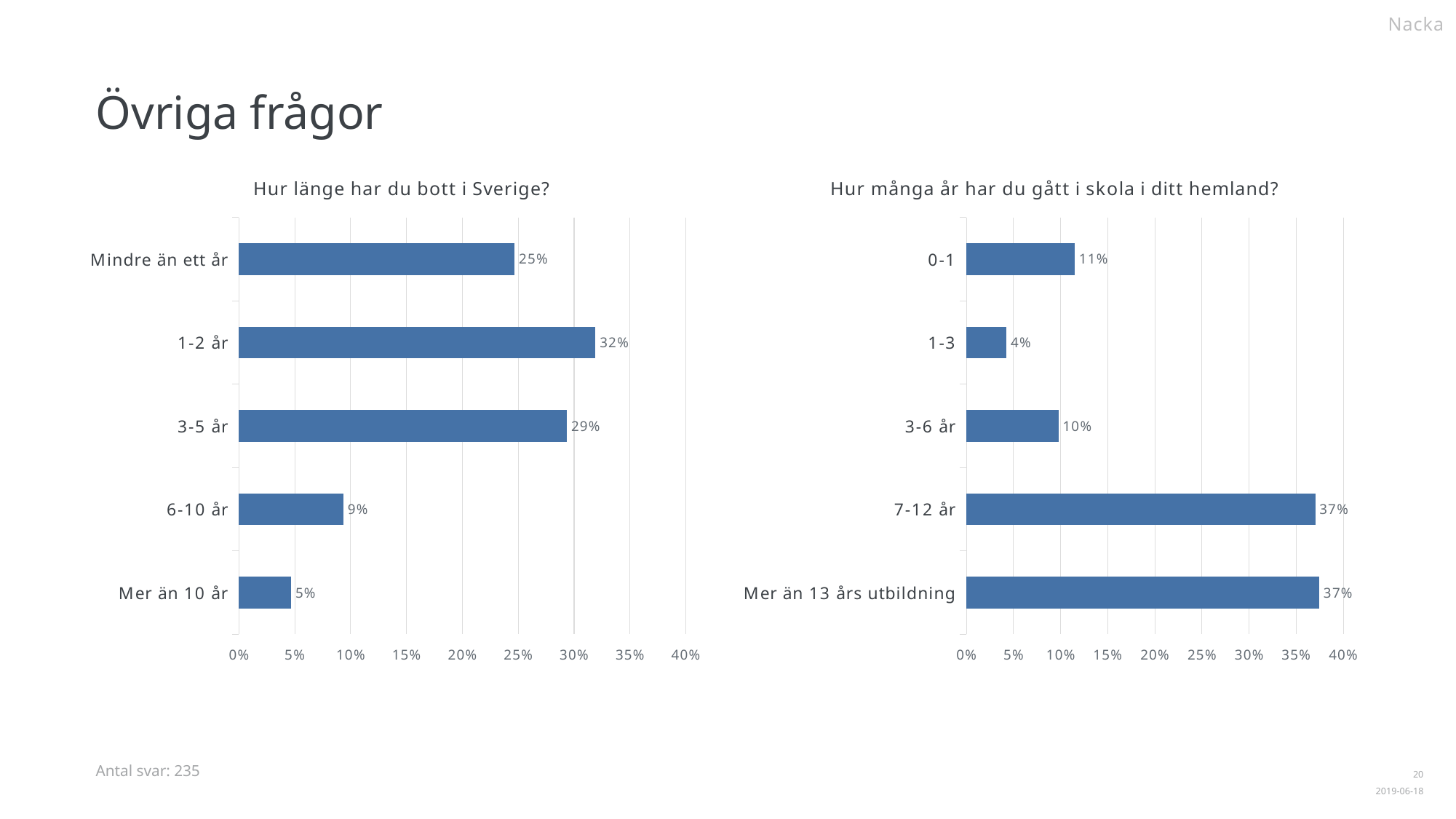
In the chart 'Hur många år har du gått i skola i ditt hemland?', which is larger: the value for '0-1' or the value for '3-6 år'? 0-1 In the chart 'Hur många år har du gått i skola i ditt hemland?', what is the value for 'Mer än 13 års utbildning'? 37% In the chart 'Hur många år har du gått i skola i ditt hemland?', what is the value for '0-1'? 11% In the chart 'Hur länge har du bott i Sverige?', what is the value for '1-2 år'? 32% What kind of chart is the chart on the left of the slide? Bar chart In the chart 'Hur många år har du gått i skola i ditt hemland?', what is the difference between the values for '7-12 år' and '3-6 år'? 27% What is the title of the chart on the right of the slide? Hur många år har du gått i skola i ditt hemland? In the chart 'Hur länge har du bott i Sverige?', how many categories are shown? 5 In the chart 'Hur länge har du bott i Sverige?', which category has the highest value? 1-2 år In the chart 'Hur länge har du bott i Sverige?', what is the difference between the values for '3-5 år' and '6-10 år'? 20% In the chart 'Hur länge har du bott i Sverige?', which category has the lowest value? Mer än 10 år In the chart 'Hur många år har du gått i skola i ditt hemland?', which category has the lowest value? 1-3